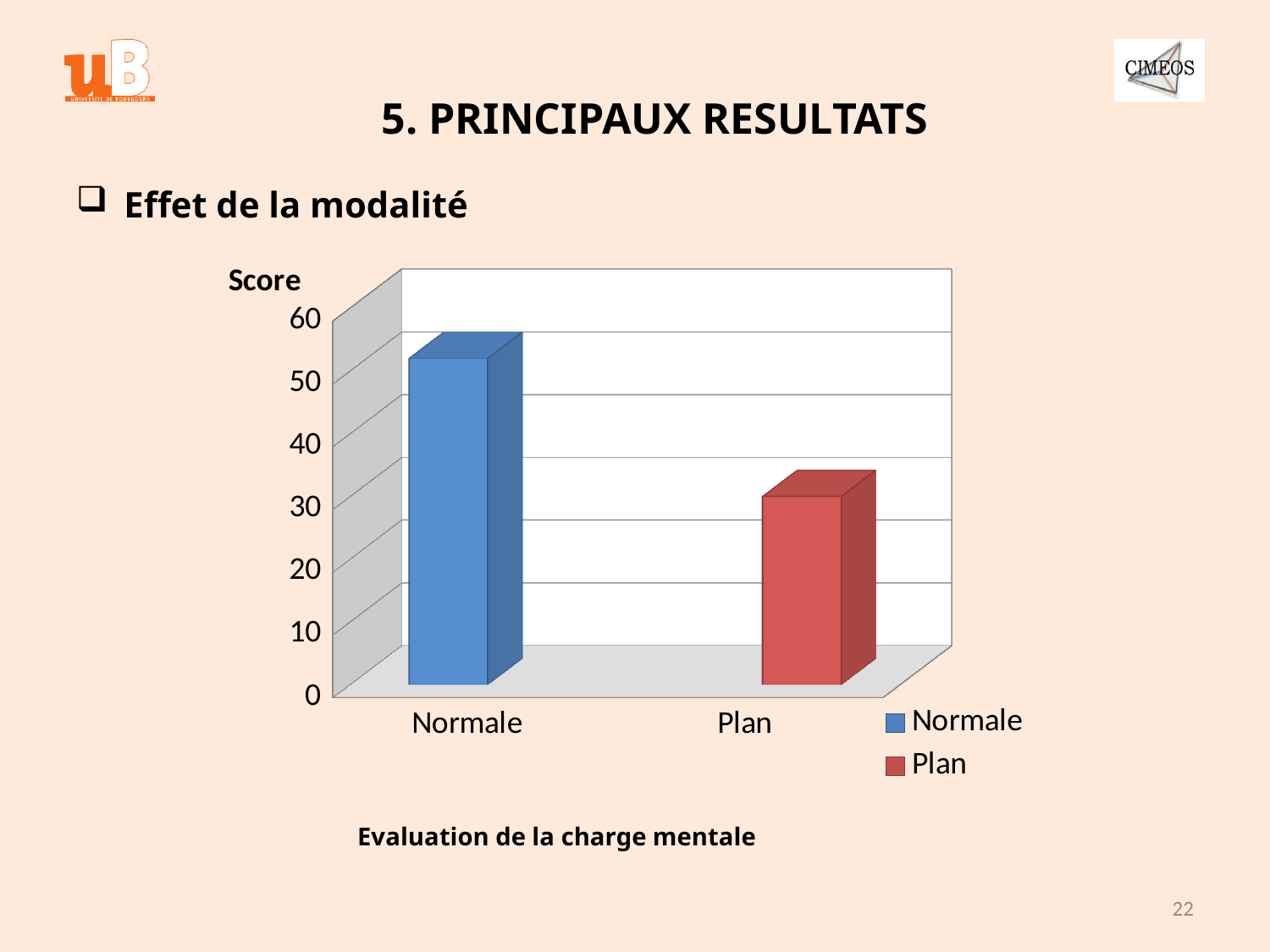
What is the title shown below the chart? Evaluation de la charge mentale How many entries does the chart's legend list? 2 How many categories are plotted on the x axis of the chart? 2 Which has the larger score, Normale or Plan? Normale Is the score for Normale greater or less than 60? less Which category has the highest score in the chart? Normale What colour is the bar for Normale in the chart? blue Which category has the lowest score in the chart? Plan Is the score for Plan greater or less than 20? greater What kind of chart is shown on the slide? bar chart Is the score for Normale greater or less than 40? greater